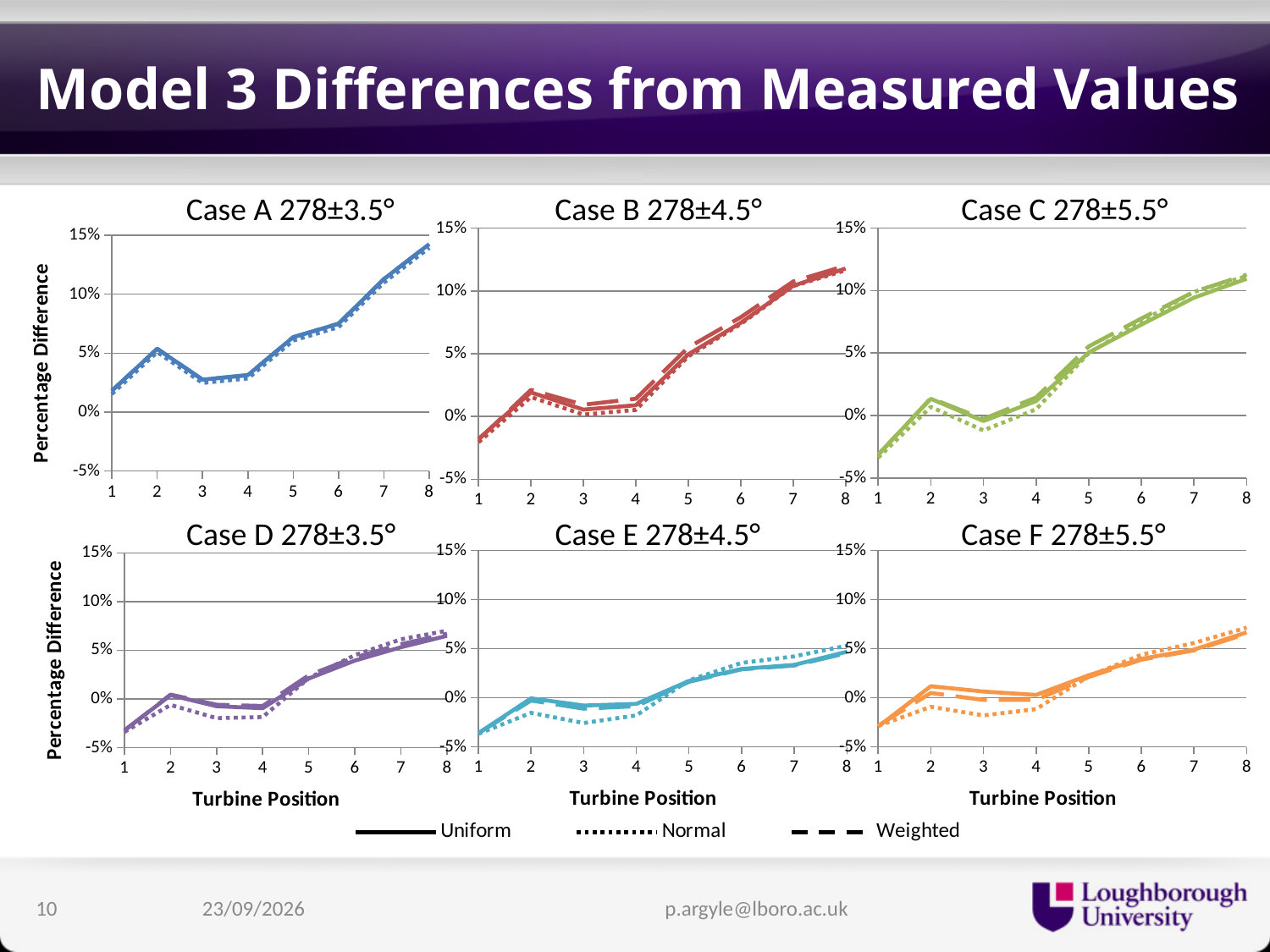
In the Case A 278±3.5° chart, which turbine position has the highest percentage difference? 8 In the Case A 278±3.5° chart, is the Uniform value at turbine position 8 greater or less than 10%? greater At turbine position 8, is the Uniform value larger in the Case A 278±3.5° chart or the Case E 278±4.5° chart? Case A 278±3.5° How many series does the legend at the bottom of the slide list? 3 What kind of chart is used for Case A 278±3.5°? line chart What are the three series named in the legend? Uniform, Normal, Weighted How many turbine positions are plotted along the x axis of the Case D 278±3.5° chart? 8 In the Case F 278±5.5° chart, is the Normal value at turbine position 1 greater or less than 0%? less In the Case D 278±3.5° chart, is the Uniform value at turbine position 8 greater or less than 5%? greater In the Case C 278±5.5° chart, do the values rise or fall from turbine position 4 to turbine position 8? rise In the Case B 278±4.5° chart, which turbine position has the lowest percentage difference? 1